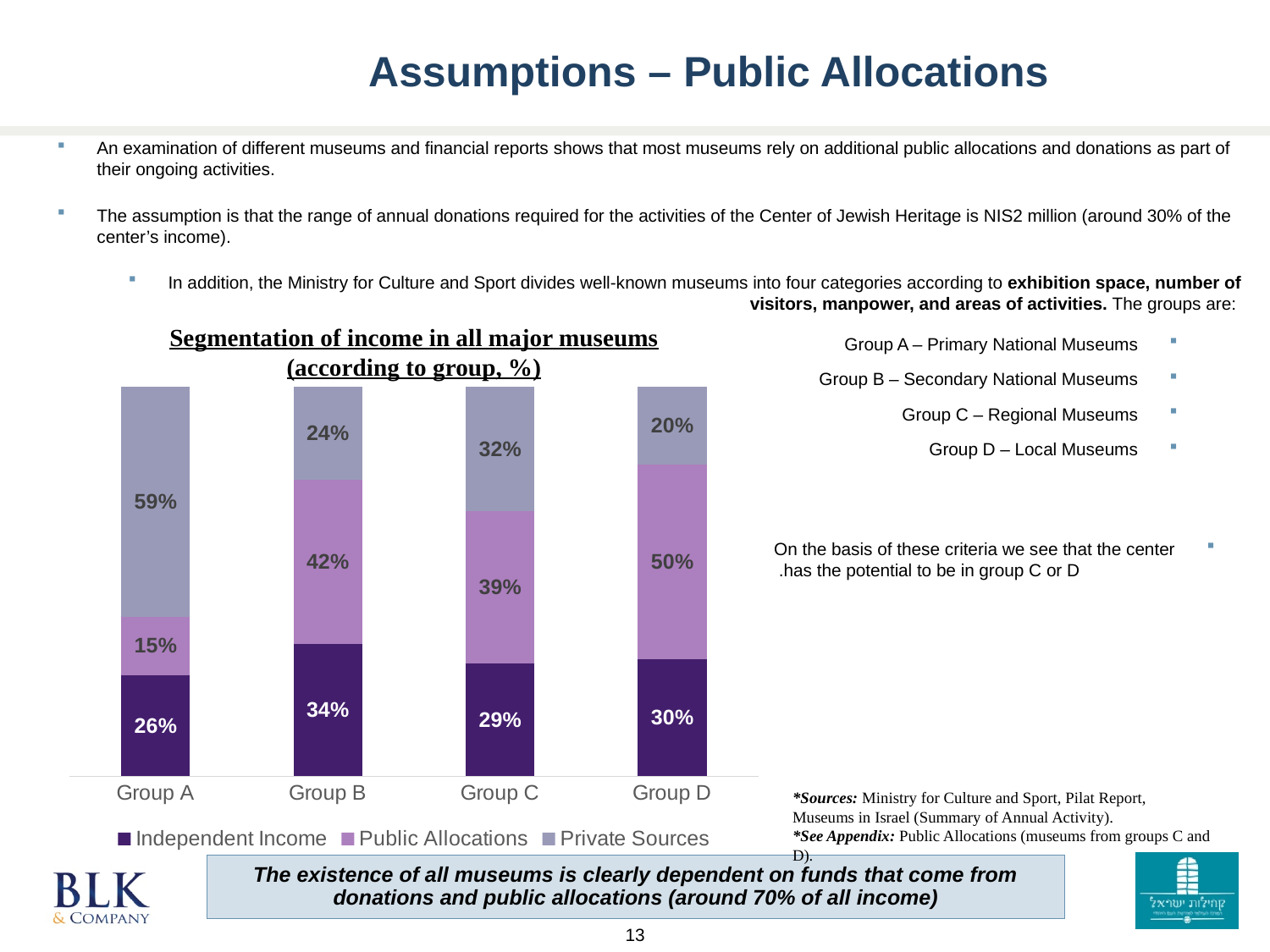
What is the Public Allocations value for Group C? 39% What is the Public Allocations value for Group D? 50% What is the difference between the Public Allocations values for Group D and Group B? 8% What is the total of the stacked bar for Group C? 100% What is the Independent Income value for Group B? 34% How many series does the legend list? 3 Which group has the lowest Public Allocations share? Group A Which is larger, the Private Sources value for Group C or for Group B? Group C How many groups are shown on the x axis? 4 What kind of chart is shown on the slide? Stacked bar chart Which group has the highest Private Sources share? Group A What is the Private Sources value for Group A? 59%